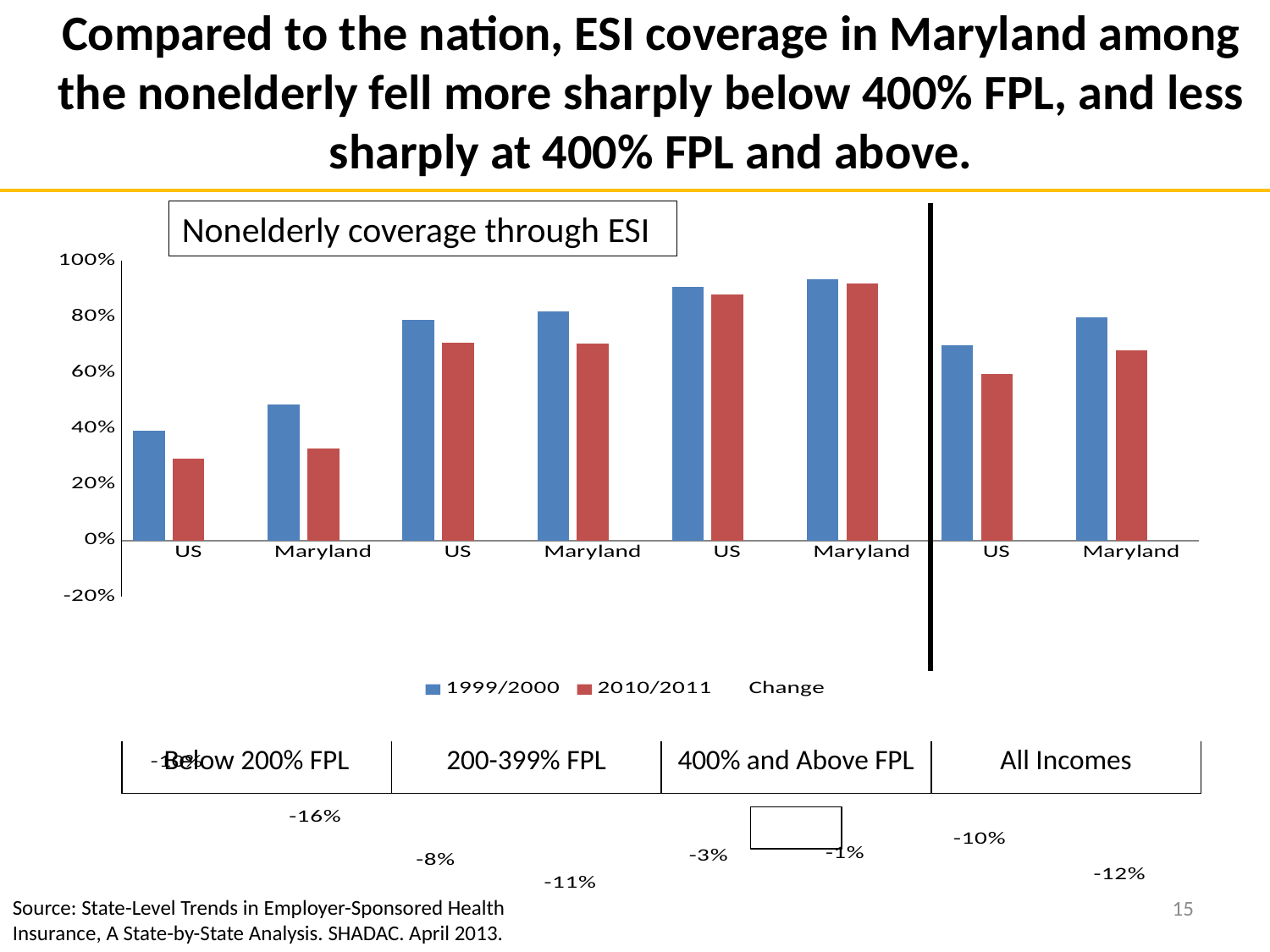
What kind of chart is shown on the slide? bar chart In the 200-399% FPL group, how many percentage points larger is the decline for Maryland than for the US? 3 percentage points Is the 1999/2000 value for Maryland in the 400% and Above FPL group greater or less than 80%? greater What is the Change value for Maryland in the 200-399% FPL group? -11% How many series does the chart legend list? 3 What is the Change value for the US in the 400% and Above FPL group? -3% What is the Change value for Maryland in the All Incomes group? -12% Is the 2010/2011 value for Maryland in the Below 200% FPL group greater or less than 40%? less How many income groups are shown along the x axis of the chart? 4 In the Below 200% FPL group, which had higher 1999/2000 ESI coverage, the US or Maryland? Maryland What is the title of the chart? Nonelderly coverage through ESI What is the Change value for Maryland in the Below 200% FPL group? -16%